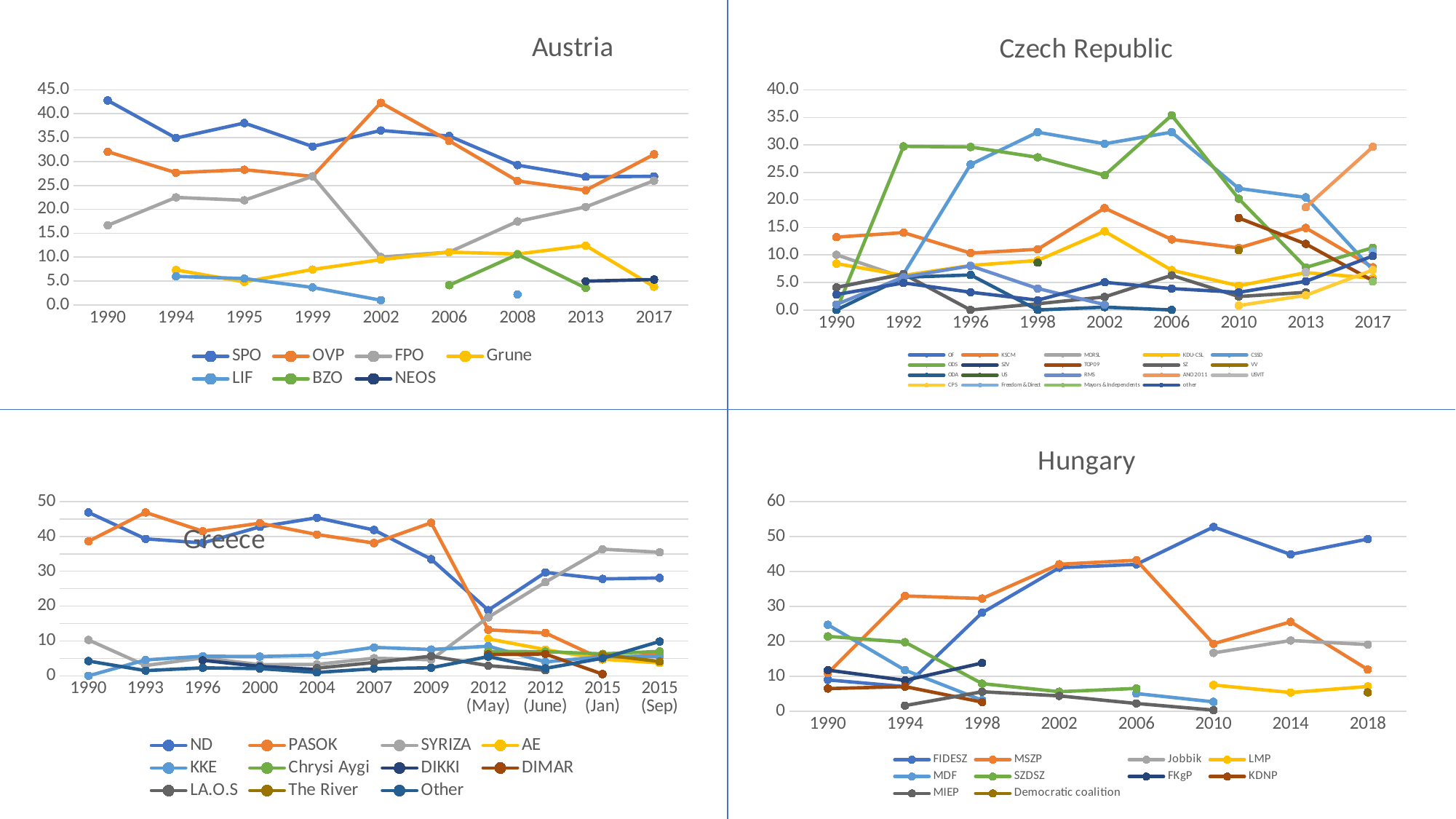
In the Hungary chart, does the value for MSZP rise or fall from 2006 to 2018? fall In the Greece chart, which series has the highest value in 2015 (Sep)? SYRIZA In the Austria chart, how many series does the legend list? 7 In the Hungary chart, is the value for FIDESZ in 2010 greater or less than 50? greater In the Austria chart, which is larger in 2017, SPO or OVP? OVP In the Czech Republic chart, how many years are shown on the x axis? 9 In the Greece chart, how many series does the legend list? 11 What kind of chart is the Austria chart? line chart In the Hungary chart, how many years are shown on the x axis? 8 In the Austria chart, is the value for SPO in 1990 greater or less than 40? greater In the Austria chart, which series has the highest value in 1990? SPO In the Greece chart, is the value for ND in 1990 greater or less than 40? greater